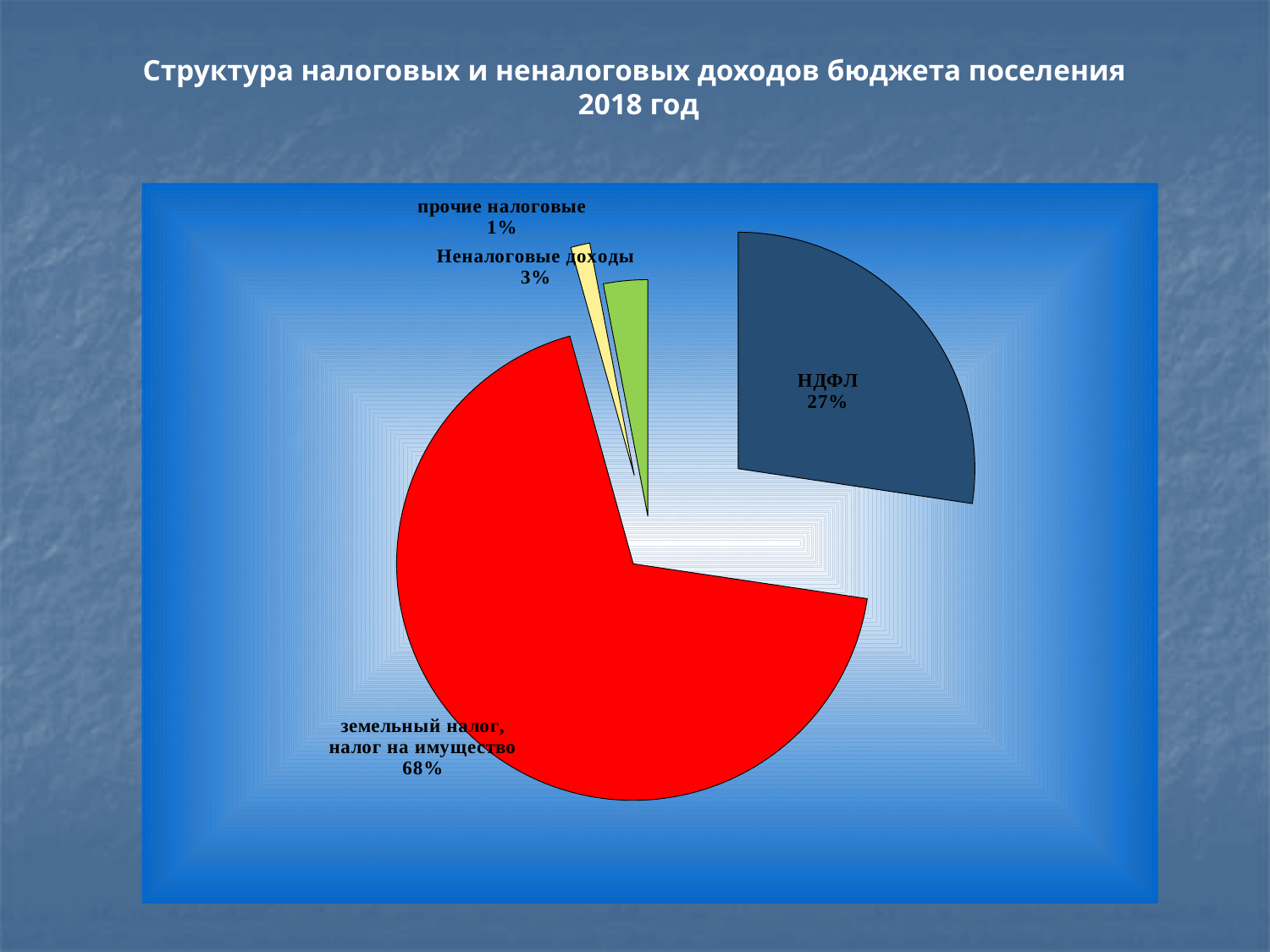
What share of the pie does НДФЛ represent? 27% What share of the pie does земельный налог, налог на имущество represent? 68% What is the difference in percentage points between земельный налог, налог на имущество and НДФЛ? 41 Which category has the largest slice of the pie? земельный налог, налог на имущество What is the title of the slide? Структура налоговых и неналоговых доходов бюджета поселения 2018 год What is the value shown for Неналоговые доходы? 3% What is the value shown for прочие налоговые? 1% Which is larger, the share for НДФЛ or the share for Неналоговые доходы? НДФЛ How many slices does the pie chart have? 4 What kind of chart is shown on the slide? pie chart What colour is the slice for земельный налог, налог на имущество? red Which category has the smallest slice of the pie? прочие налоговые